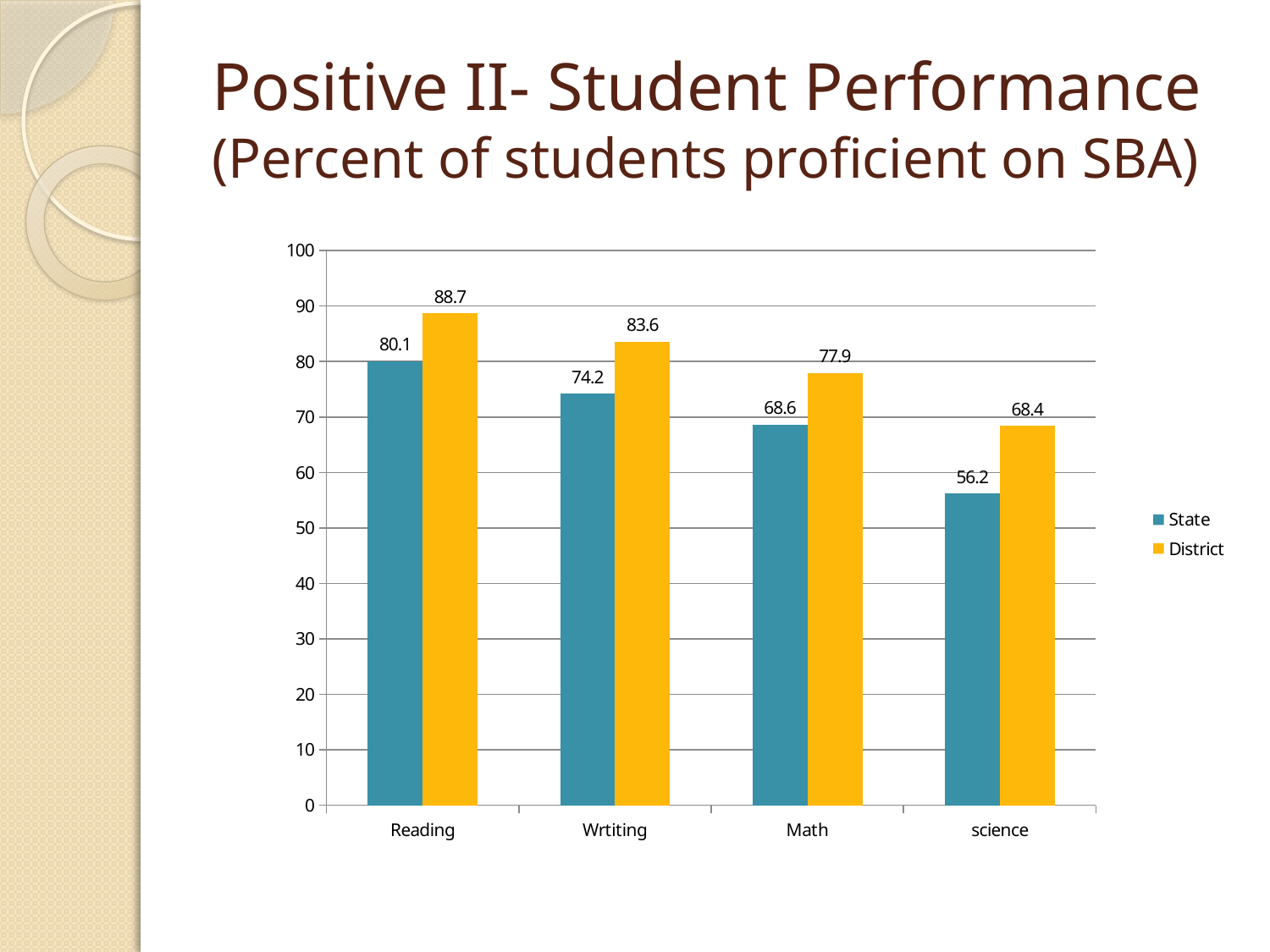
What is the difference between the District and State values for Wrtiting? 9.4 What kind of chart is shown on the slide? bar chart Which category has the highest District value? Reading Which category has the lowest State value? science Is the State value for science greater or less than 60? less What is the difference between the District and State values for science? 12.2 How many categories are shown on the x axis? 4 How many series does the legend list? 2 What is the State value for Reading? 80.1 Which is larger, the State value for Math or the District value for Math? District What is the District value for science? 68.4 What is the District value for Math? 77.9